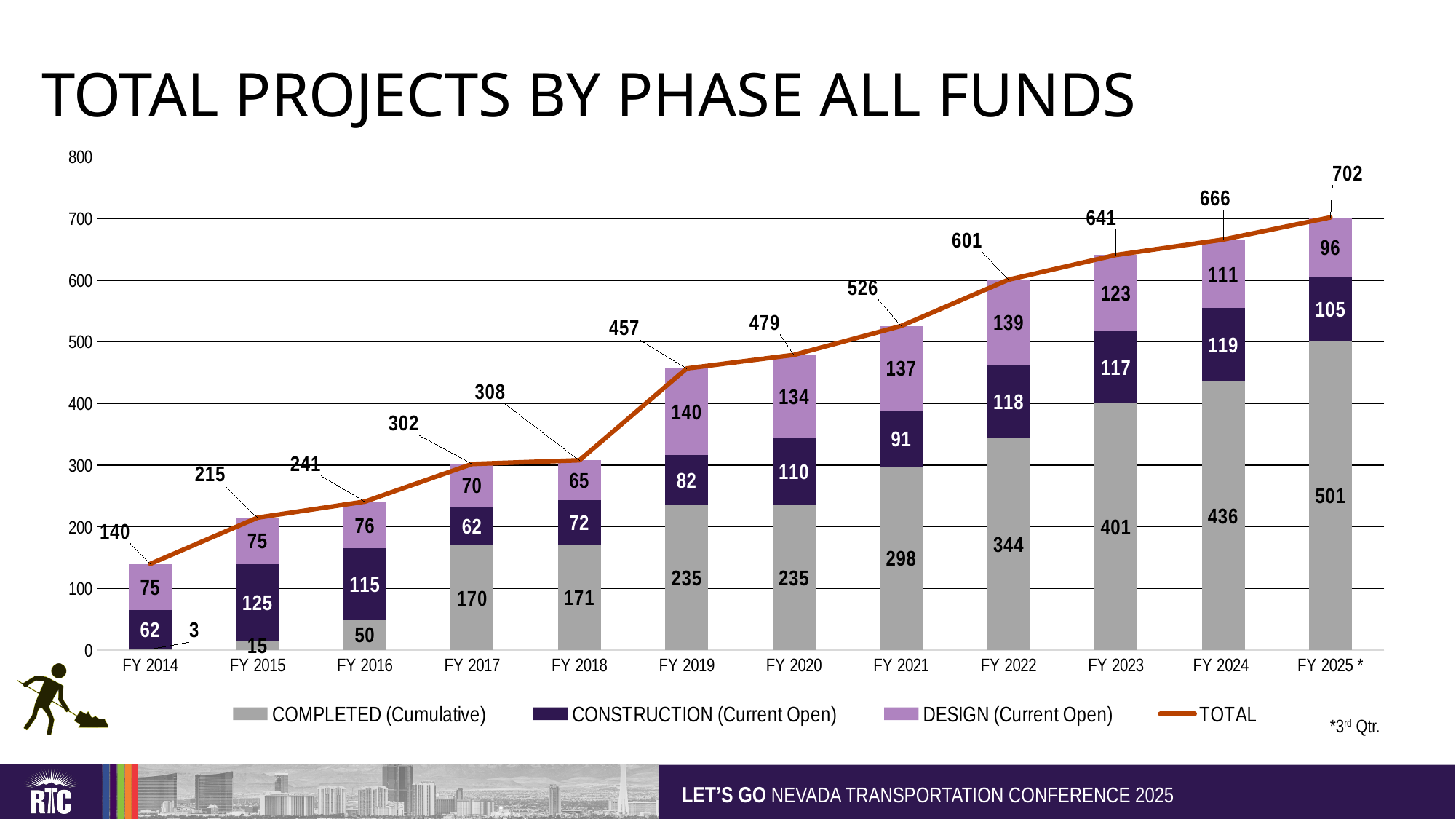
What kind of chart is shown on the slide? Stacked bar chart with a line What is the difference between the TOTAL values for FY 2024 and FY 2023? 25 How many series does the legend list? 4 What is the DESIGN (Current Open) value for FY 2019? 140 Which fiscal year has the highest TOTAL value? FY 2025 * What is the TOTAL value shown for FY 2021? 526 What is the COMPLETED (Cumulative) value for FY 2022? 344 Which is larger, the DESIGN (Current Open) value for FY 2022 or for FY 2024? FY 2022 Which fiscal year has the lowest COMPLETED (Cumulative) value? FY 2014 Does the TOTAL line rise or fall from FY 2014 to FY 2025? Rise How many fiscal years are shown on the x axis? 12 What is the CONSTRUCTION (Current Open) value for FY 2015? 125